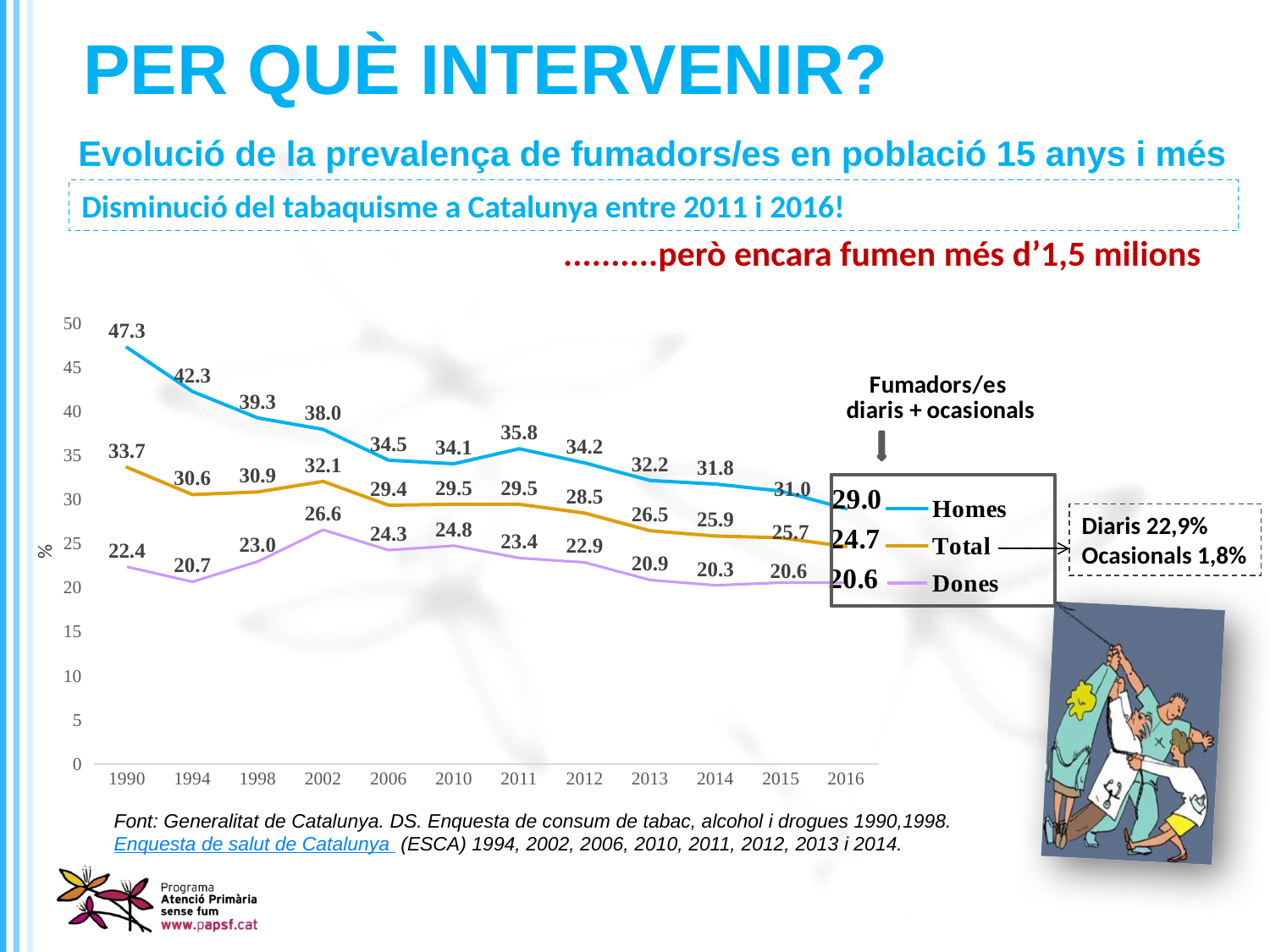
What kind of chart is shown on the slide? Line chart In which year is the Dones series at its highest? 2002 How many series does the legend list? 3 What is the difference between the Homes value in 1990 and the Homes value in 2016? 18.3 How many years are plotted along the x axis? 12 Which series is drawn in purple? Dones What is the value for Total in 2016? 24.7 Which is larger, the Total value in 2011 or the Total value in 2013? 2011 In which year is the Homes series at its lowest? 2016 What is the value for Dones in 2002? 26.6 What is the value for Homes in 1990? 47.3 Does the Homes series generally rise or fall from 1990 to 2016? Fall